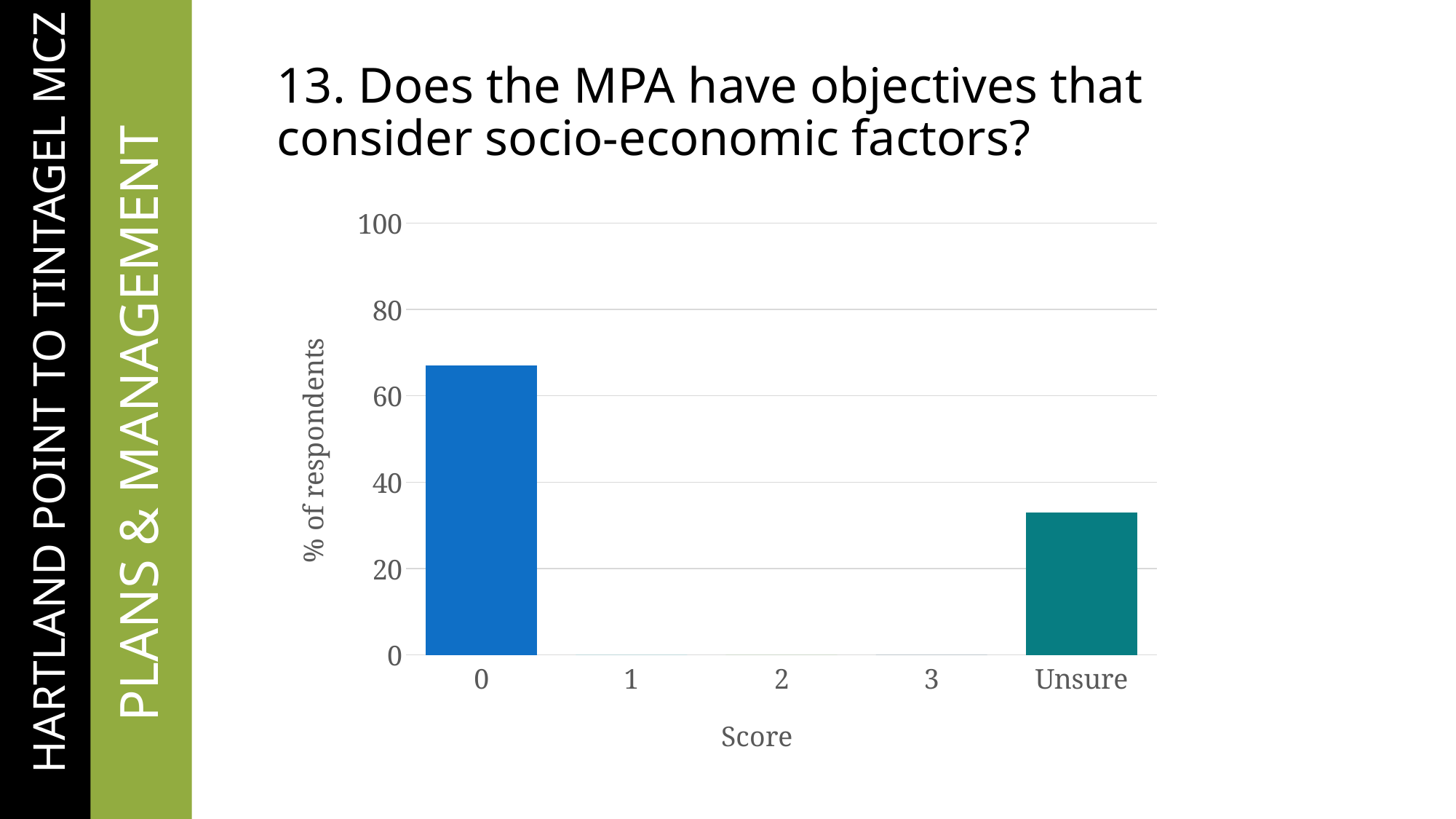
Is the value for Unsure greater or less than 40? less What kind of chart is shown on the slide? bar chart Is the value for score 0 greater or less than 60? greater Which is larger, the value for score 0 or the value for Unsure? 0 Which score categories have no visible bar in the chart? 1, 2 and 3 What is the label of the y axis? % of respondents Is the value for score 0 greater or less than 80? less Which score category has the highest percentage of respondents? 0 What is the label of the x axis? Score How many categories are shown on the x axis of the chart? 5